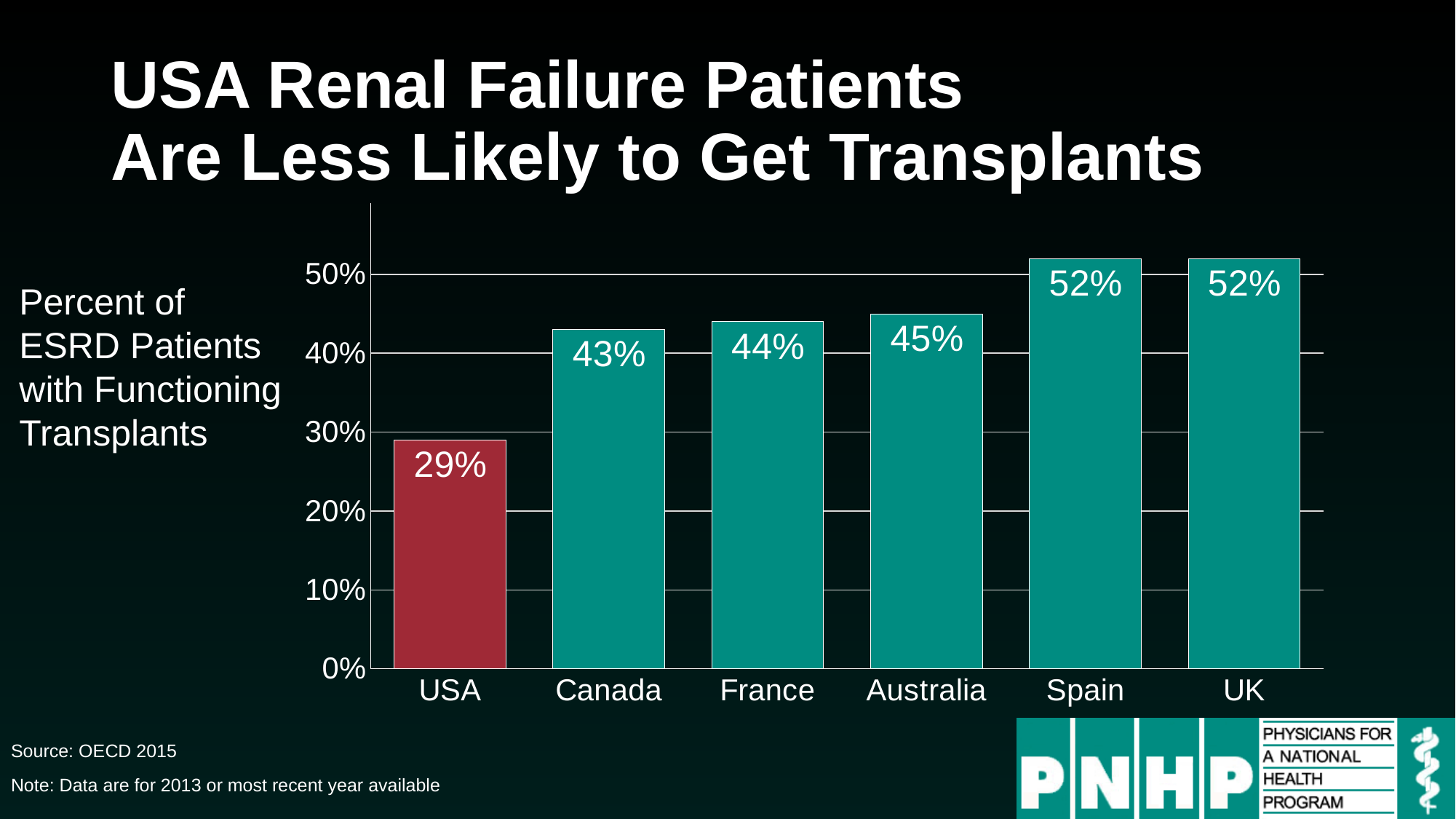
Is the value for Spain greater or less than 50%? greater What is the difference between the values for the UK and the USA? 23% Which is larger, the value for France or the value for Canada? France How many countries are shown in the chart? 6 What is the value shown for Australia? 45% Which country has the lowest percent of ESRD patients with functioning transplants? USA What is the difference between the values for Australia and Canada? 2% What is the value shown for Canada? 43% What kind of chart is shown on the slide? Bar chart Which bar is coloured differently from the others? USA Is the value for USA greater or less than 30%? less What percent of ESRD patients in the USA have functioning transplants? 29%